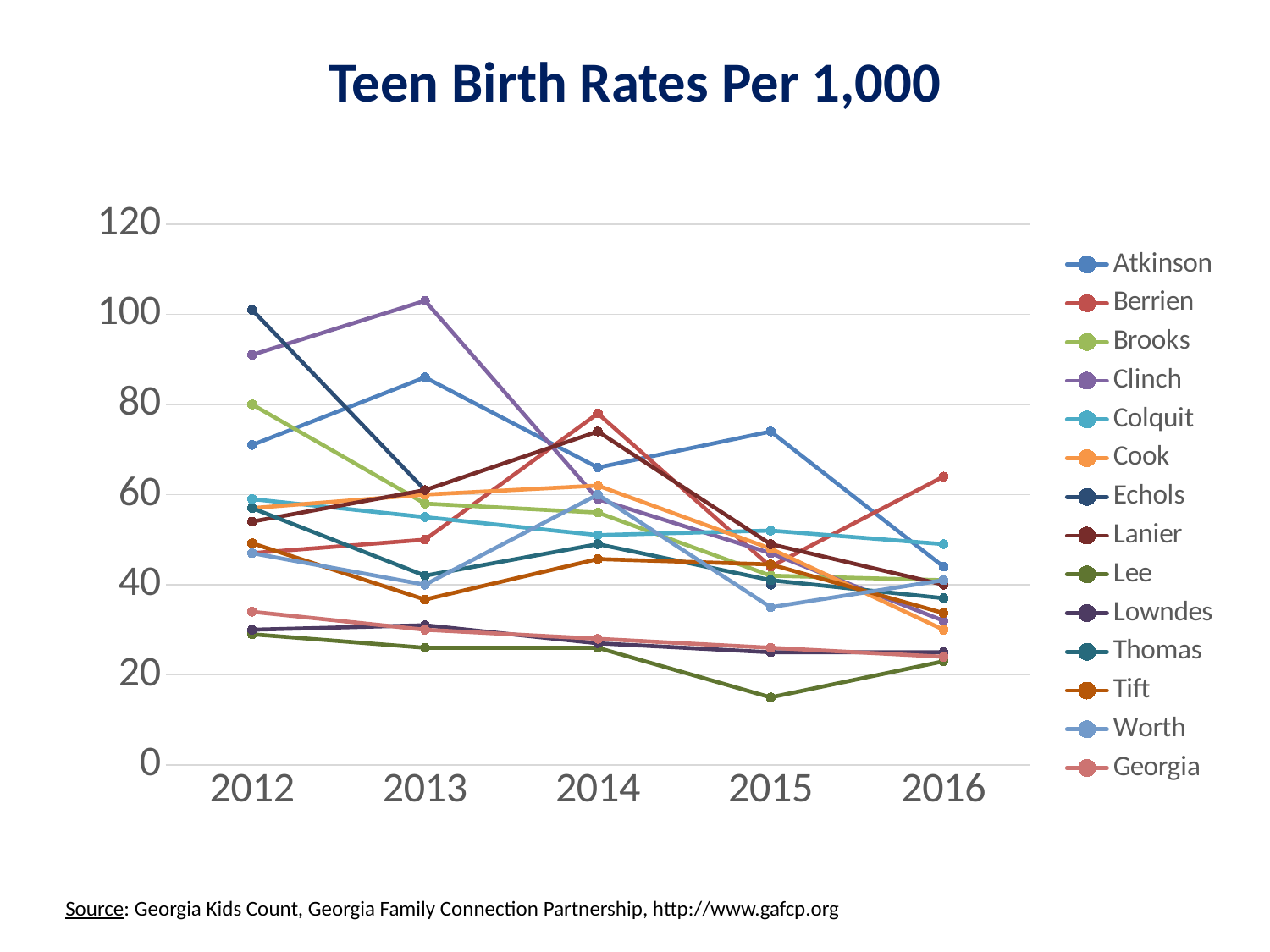
How many series does the legend list? 14 How many years are shown on the x axis? 5 Which series has the highest value in 2012? Echols Which county has the highest teen birth rate in 2013? Clinch What kind of chart is shown on the slide? line chart Which series has the lowest value in 2015? Lee Is the value for Clinch in 2013 greater or less than 100? greater Is the value for Atkinson in 2013 greater or less than 80? greater Is the value for Lee in 2015 greater or less than 20? less What is the title of the chart? Teen Birth Rates Per 1,000 In 2012, which is higher, Echols or Atkinson? Echols Does the Georgia line rise or fall from 2012 to 2016? fall